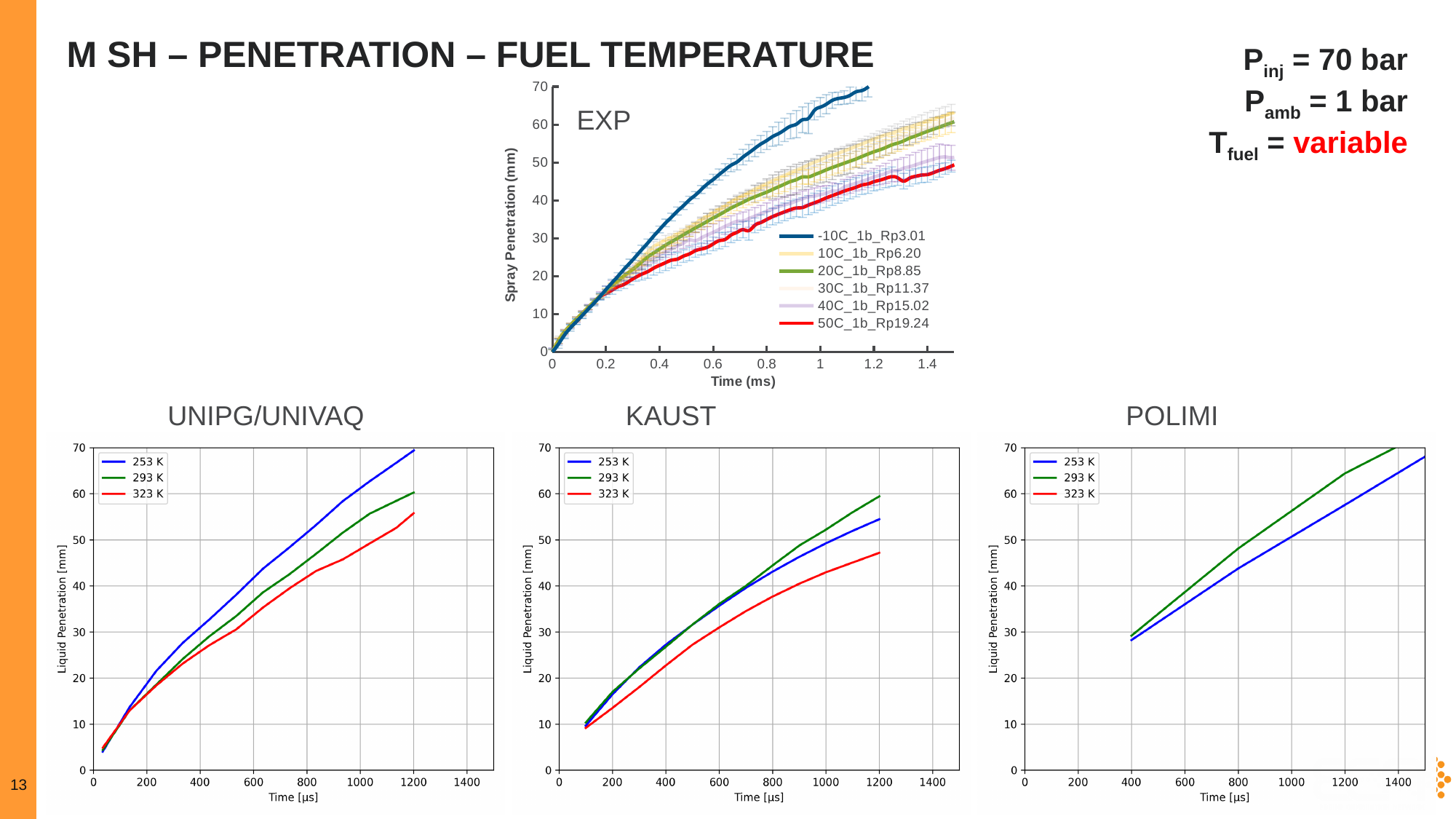
In the UNIPG/UNIVAQ chart, is the value for 253 K at 1200 µs greater or less than 60? greater In the EXP chart, which series reaches the highest spray penetration? -10C_1b_Rp3.01 In the UNIPG/UNIVAQ chart, how many series does the legend list? 3 In the EXP chart, what is the x-axis label? Time (ms) What is the y-axis label of the KAUST chart? Liquid Penetration [mm] In the KAUST chart, which series is higher at 1200 µs, 253 K or 293 K? 293 K In the POLIMI chart, do the plotted values rise or fall as time increases? rise In the POLIMI chart, which series is higher at 1200 µs, 253 K or 293 K? 293 K In the EXP chart, how many series does the legend list? 6 In the UNIPG/UNIVAQ chart, which series is higher at 1200 µs, 253 K or 323 K? 253 K What type of chart is the EXP chart at the top of the slide? line chart In the KAUST chart, is the value for 323 K at 1200 µs greater or less than 50? less